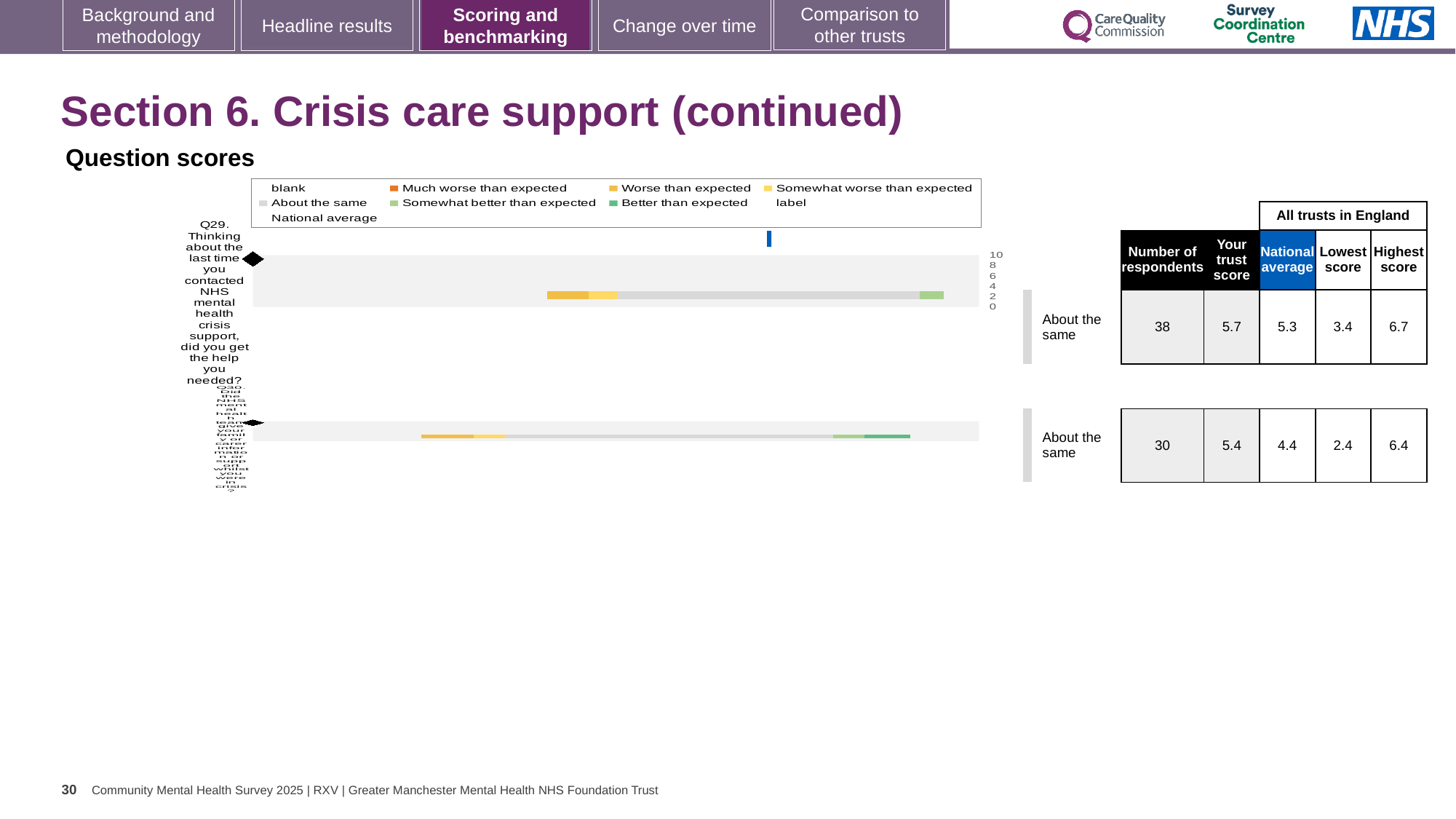
What is the national average score for Q29? 5.3 Which of the two questions has the higher trust score? Q29 What is the difference between the highest score and the lowest score for Q30? 4.0 How many respondents answered Q30, the second question in the chart? 30 What is the lowest score among all trusts in England for Q30? 2.4 How many questions (bars) are plotted in the question scores chart? 2 For Q29, which is larger: the trust score or the national average? the trust score What benchmark category is shown for Q29 next to the chart? About the same How many entries does the legend of the question scores chart list? 9 What kind of chart is used to show the question scores on this slide? bar chart What is the maximum value shown on the score axis of the chart? 10 What is the trust score for Q29 (Thinking about the last time you contacted NHS mental health crisis support, did you get the help you needed?)? 5.7